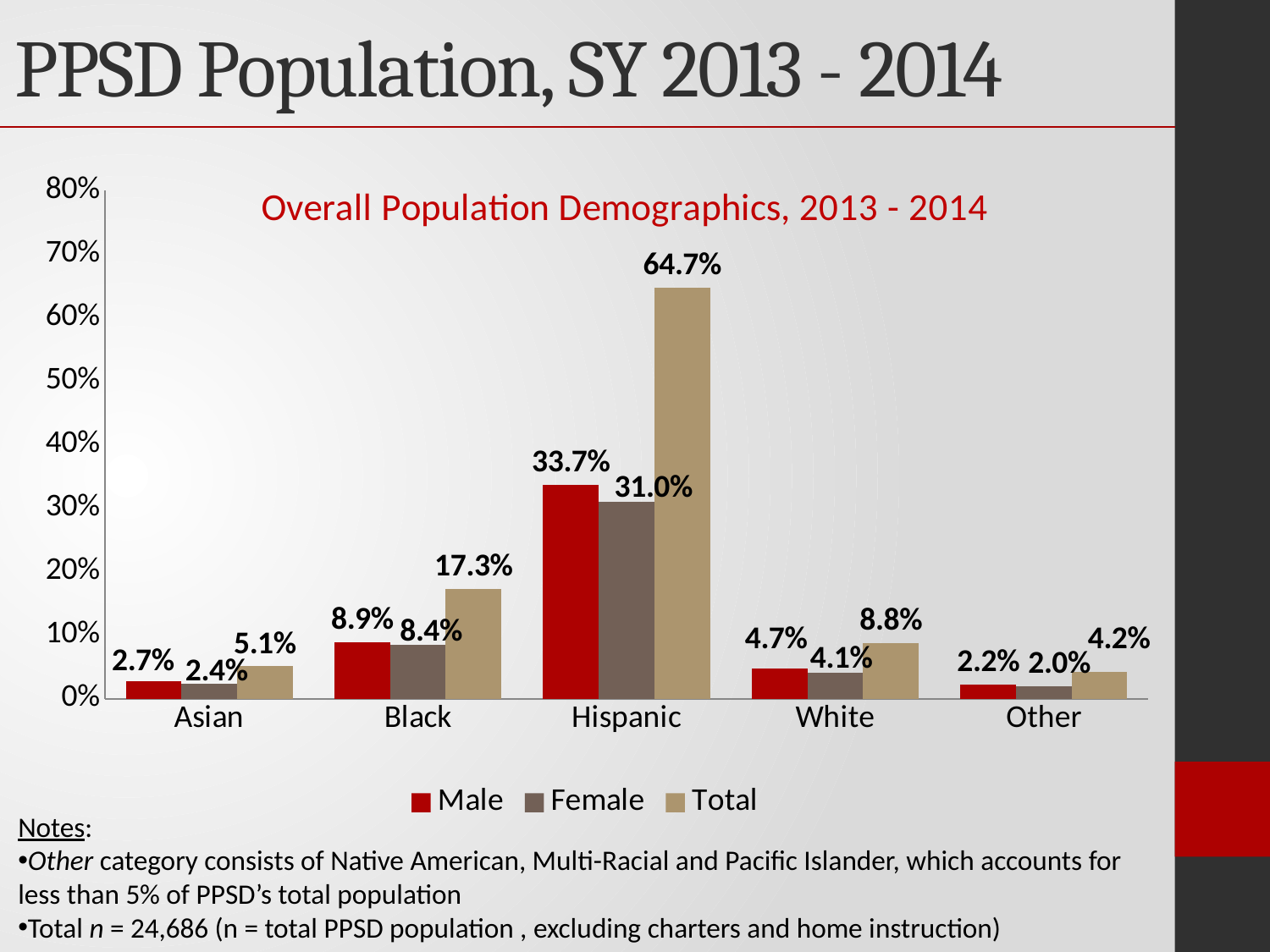
Which is larger, the Total value for Black or the Total value for White? Black What is the Female value for White? 4.1% What kind of chart is shown on the slide? bar chart What is the Male value for Black? 8.9% Is the Total value for Hispanic greater or less than 60%? greater Which category has the highest Total value? Hispanic Which category has the lowest Female value? Other How many categories are shown on the x axis? 5 How many series does the legend list? 3 What is the difference between the Male and Female values for Hispanic? 2.7% What is the Total value for Hispanic? 64.7% What is the title of the chart? Overall Population Demographics, 2013 - 2014